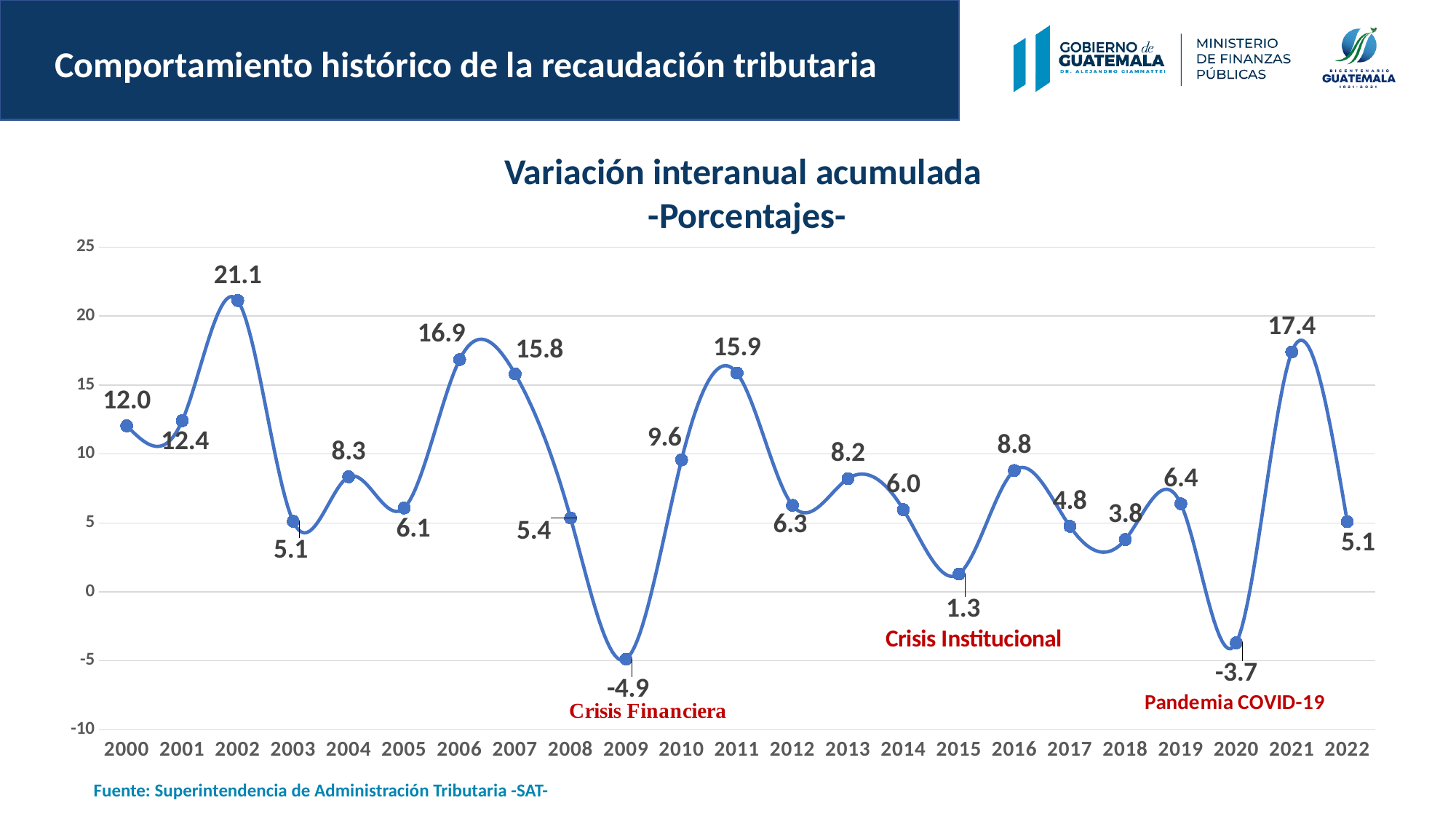
Do the values rise or fall from 2019 to 2020? Fall Is the value for 2011 greater or less than 10? greater Which is larger, the value for 2006 or the value for 2007? 2006 What kind of chart is shown? Line chart What is the difference between the values for 2021 and 2022? 12.3 How many years are plotted on the x axis? 23 What is the value for 2002? 21.1 What is the value for 2009? -4.9 Which year has the highest value? 2002 Which year has the lowest value? 2009 What is the value for 2020? -3.7 What is the title of the chart? Variación interanual acumulada -Porcentajes-